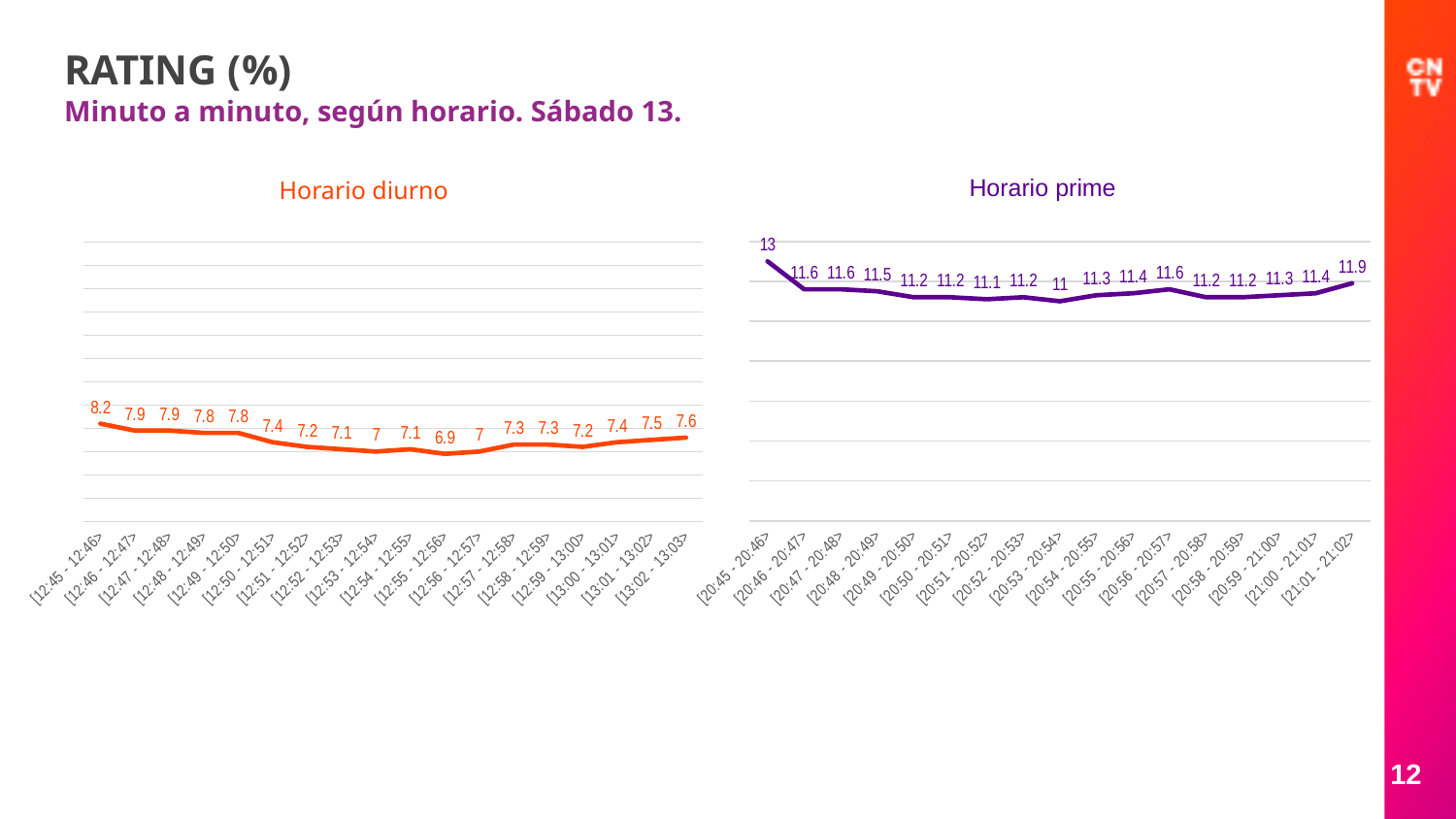
In the Horario diurno chart, what is the difference between the highest value (8.2) and the lowest value (6.9)? 1.3 What colour is the line in the Horario prime chart? Purple What type of chart is the Horario diurno chart? Line chart In the Horario diurno chart, which interval has the lowest rating? [12:55 - 12:56> In the Horario prime chart, which interval has the highest rating? [20:45 - 20:46> How many data points are plotted in the Horario diurno chart? 18 How many data points are plotted in the Horario prime chart? 17 In the Horario diurno chart, what is the rating for the [12:45 - 12:46> interval? 8.2 In the Horario prime chart, what is the rating for the [21:01 - 21:02> interval? 11.9 In the Horario diurno chart, which is larger: the value for [12:50 - 12:51> or the value for [13:02 - 13:03>? [13:02 - 13:03> In the Horario prime chart, which interval has the lowest rating? [20:53 - 20:54> In the Horario prime chart, what is the difference between the first value (13) and the last value (11.9)? 1.1